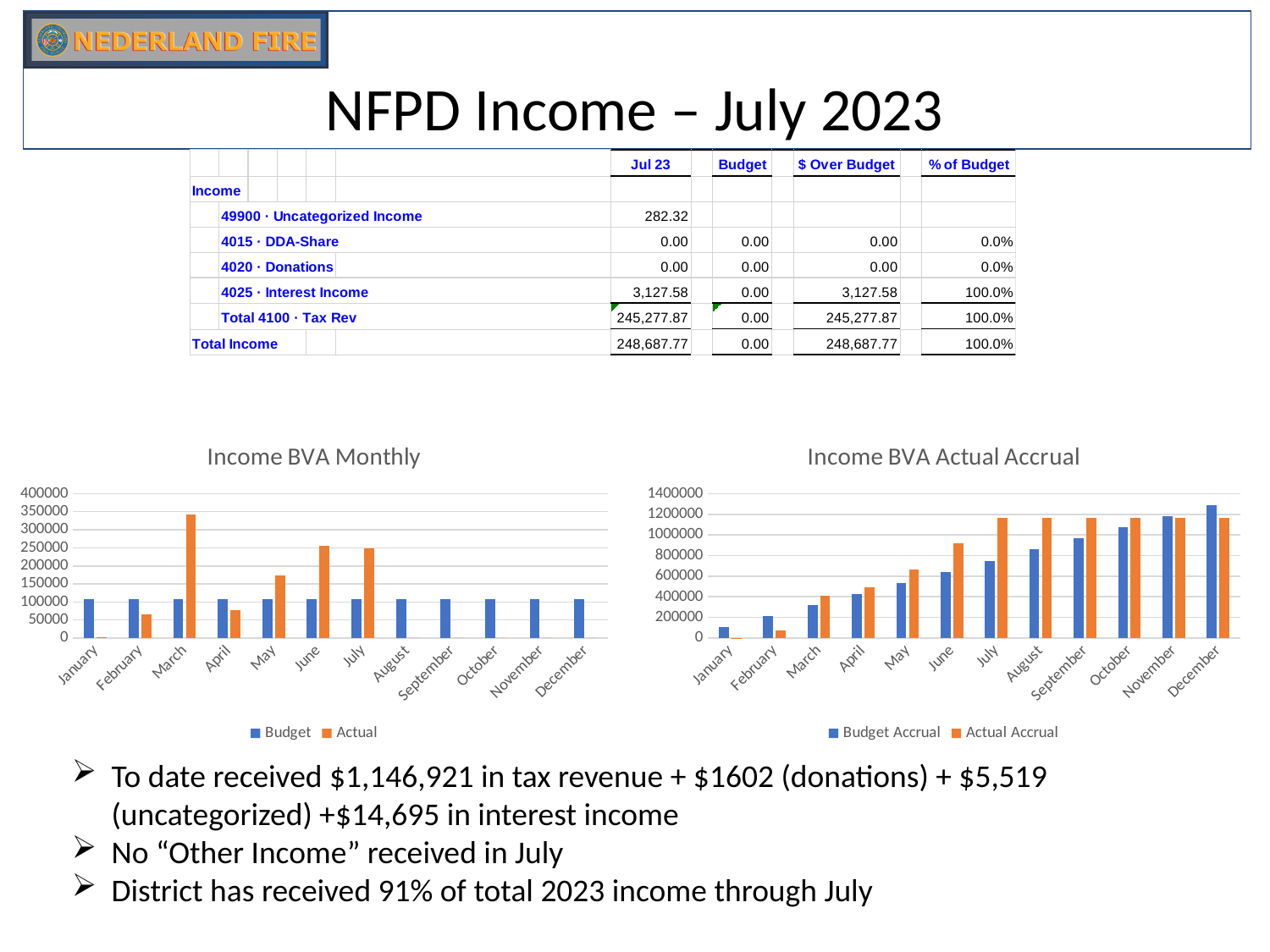
In the "Income BVA Monthly" chart, is the Actual value for February greater or less than 100000? less How many series does the legend of the "Income BVA Actual Accrual" chart list? 2 In the "Income BVA Actual Accrual" chart, is the Actual Accrual value for July greater or less than 1000000? greater What are the two legend entries of the "Income BVA Monthly" chart? Budget and Actual In the "Income BVA Monthly" chart, which month has the highest Actual value? March In the "Income BVA Monthly" chart, is the Actual value for March greater or less than 300000? greater How many months are shown on the x axis of the "Income BVA Monthly" chart? 12 What kind of chart is the "Income BVA Monthly" chart? bar chart In the "Income BVA Actual Accrual" chart, which is larger in December, Budget Accrual or Actual Accrual? Budget Accrual In the "Income BVA Actual Accrual" chart, do the Budget Accrual values rise or fall from January to December? rise In the "Income BVA Monthly" chart, which is larger in June, the Budget value or the Actual value? Actual